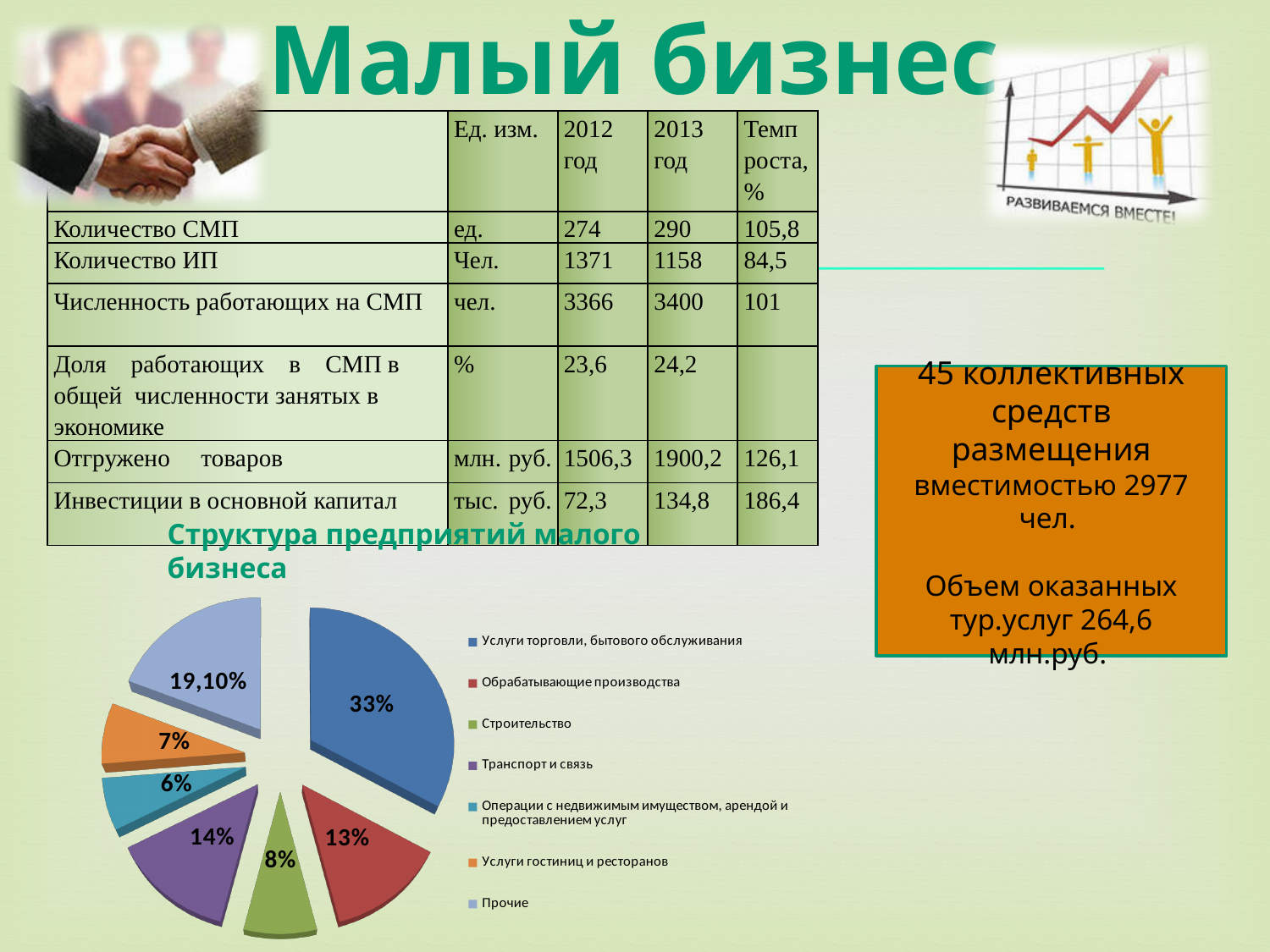
In the pie chart, what share is shown for "Прочие"? 19,10% In the pie chart, what share is shown for "Строительство"? 8% What kind of chart is shown under the heading "Структура предприятий малого бизнеса"? pie chart In the pie chart, what share is shown for "Обрабатывающие производства"? 13% Which category has the largest slice in the pie chart? Услуги торговли, бытового обслуживания In the pie chart, what share is shown for "Услуги торговли, бытового обслуживания"? 33% What is the title of the pie chart? Структура предприятий малого бизнеса In the pie chart, what share is shown for "Транспорт и связь"? 14% How many categories does the legend of the pie chart list? 7 In the pie chart, which is larger: the share for "Транспорт и связь" or for "Обрабатывающие производства"? Транспорт и связь In the pie chart, what is the difference between the share for "Услуги торговли, бытового обслуживания" and the share for "Транспорт и связь"? 19% Which category has the smallest slice in the pie chart? Операции с недвижимым имуществом, арендой и предоставлением услуг